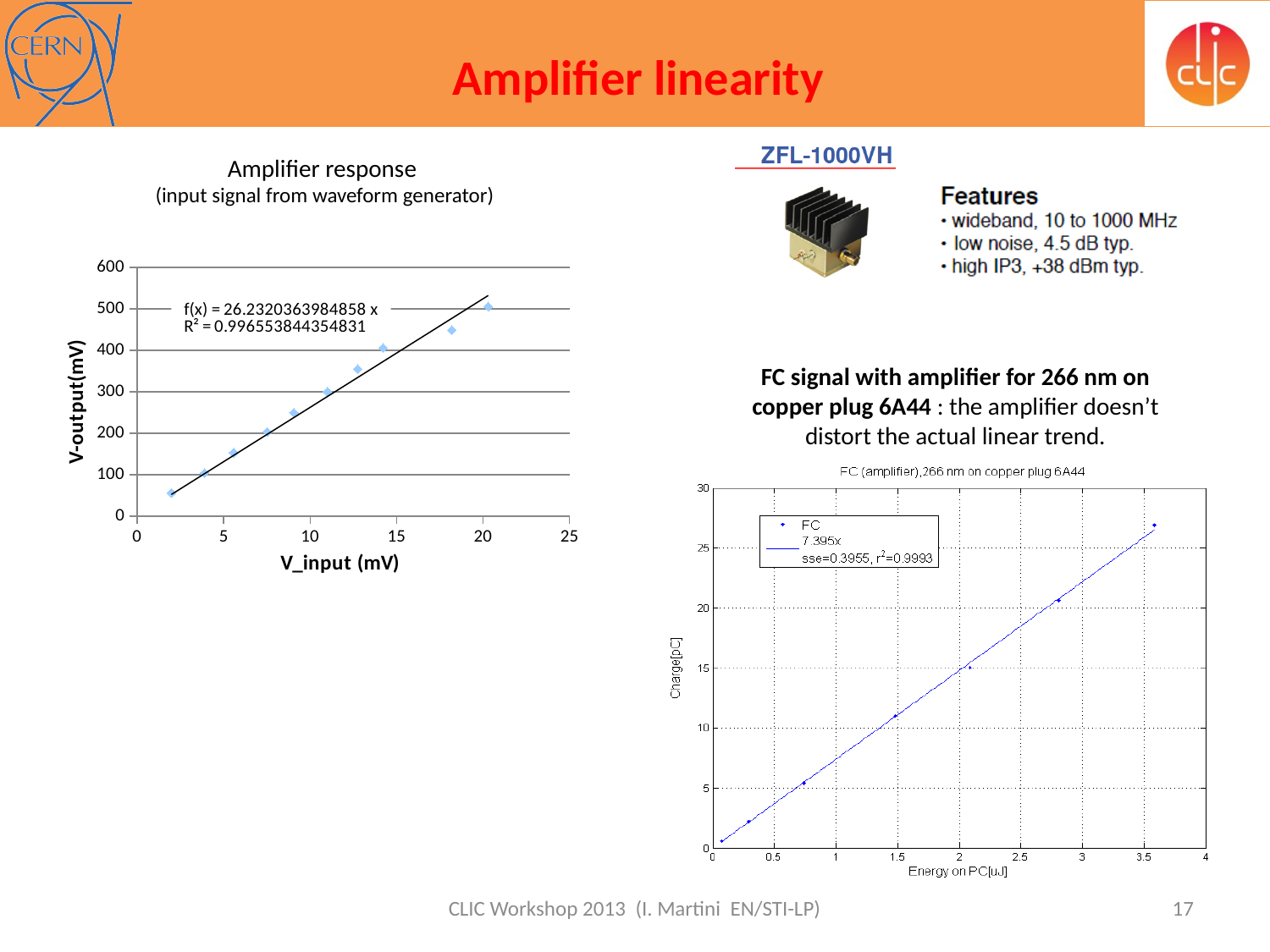
What is the label of the x axis of the "FC (amplifier), 266 nm on copper plug 6A44" chart? Energy on PC[uJ] In the "Amplifier response" chart, is the V-output for the point at about 2 mV input greater or less than 100? less In the "Amplifier response" chart, what is the highest value shown on the vertical axis? 600 In the "FC (amplifier), 266 nm on copper plug 6A44" chart, what slope is given for the fitted line in the legend? 7.395x In the "Amplifier response" chart, does V-output rise or fall as V_input increases? rise In the "FC (amplifier), 266 nm on copper plug 6A44" chart, what r² value is shown in the legend? r²=0.9993 In the "Amplifier response" chart, what is the fitted equation f(x) shown on the chart? f(x) = 26.2320363984858 x In the "FC (amplifier), 266 nm on copper plug 6A44" chart, is the charge for the point at about 3.6 uJ greater or less than 25? greater In the "Amplifier response" chart, what R² value is shown for the fit? R² = 0.996553844354831 What kind of chart is the "Amplifier response" chart on the left? scatter chart In the "Amplifier response" chart, is the V-output for the point at about 20 mV input greater or less than 400? greater What is the title of the y axis of the "Amplifier response" chart? V-output(mV)